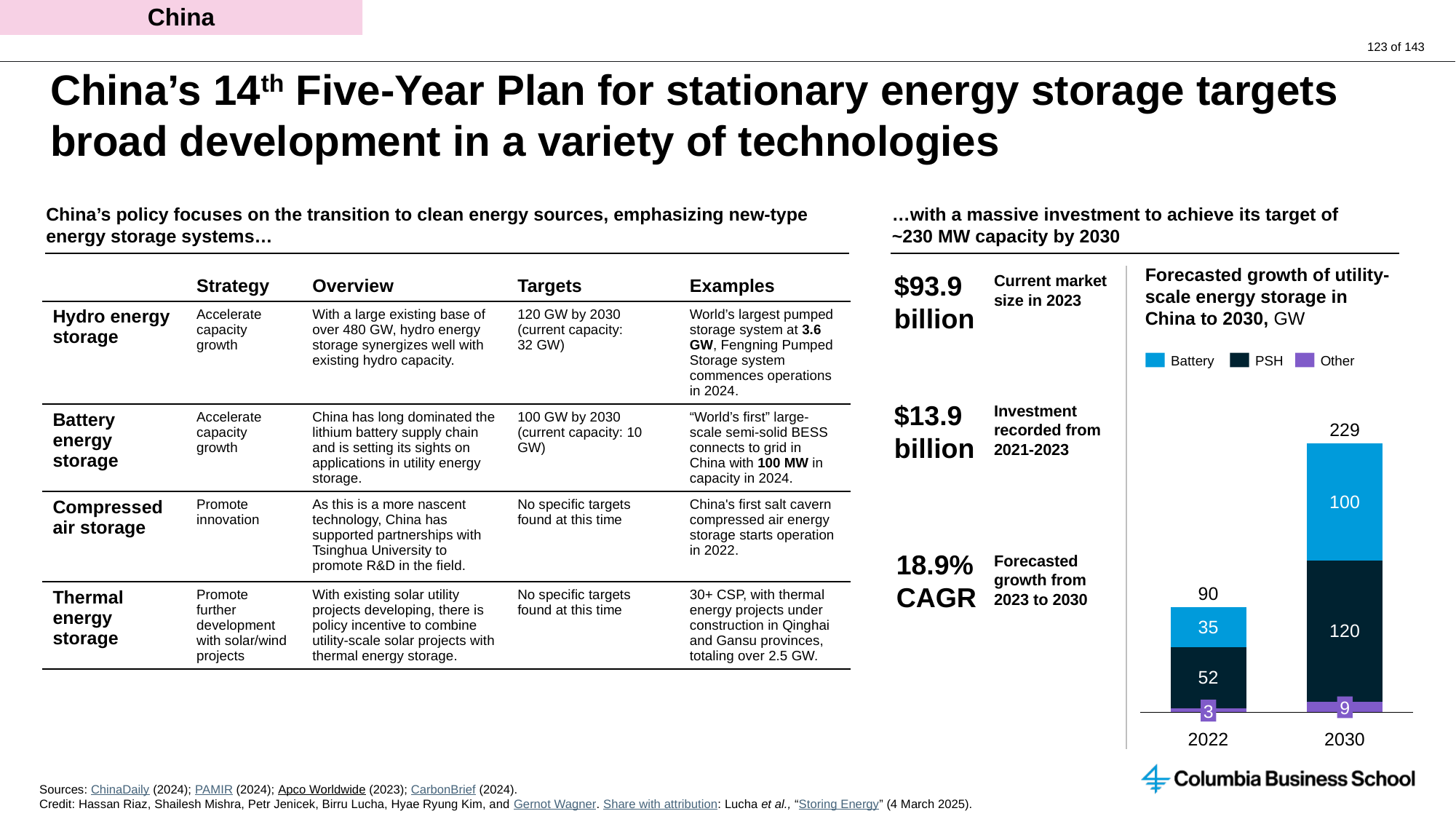
What is the difference between the total for 2030 and the total for 2022 in the forecasted growth chart? 139 Which year has the higher total in the forecasted growth chart, 2022 or 2030? 2030 What is the total of the stacked bar for 2022 in the forecasted growth chart? 90 What is the PSH value for 2022 in the forecasted growth chart? 52 What is the total of the stacked bar for 2030 in the forecasted growth chart? 229 In what unit are the values of the forecasted growth chart expressed? GW What kind of chart is the forecasted growth of utility-scale energy storage chart? Stacked bar chart How many series does the legend of the forecasted growth chart list? 3 What is the Other value for 2030 in the forecasted growth chart? 9 What is the Battery value for 2030 in the forecasted growth of utility-scale energy storage chart? 100 How many years are shown on the x axis of the forecasted growth chart? 2 What is the difference between the PSH values for 2030 and 2022 in the forecasted growth chart? 68